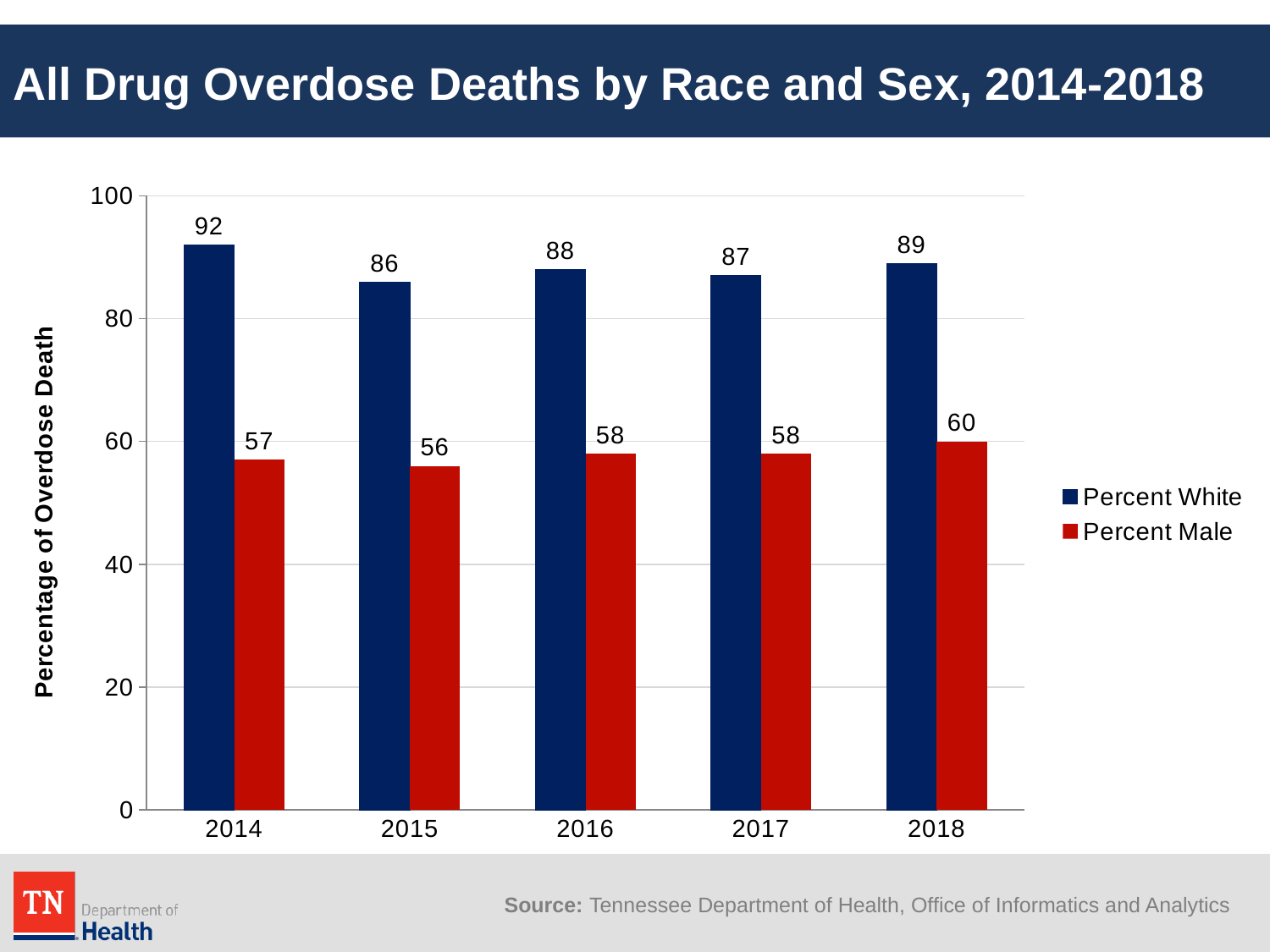
How many series does the legend list? 2 What kind of chart is shown on the slide? bar chart Is the Percent Male value for 2017 greater or less than 40? greater Which year has the lowest Percent Male value? 2015 What is the Percent Male value for 2015? 56 What is the Percent Male value for 2018? 60 Which is larger, the Percent White value for 2015 or the Percent White value for 2018? 2018 What is the title of the chart? All Drug Overdose Deaths by Race and Sex, 2014-2018 Which year has the highest Percent White value? 2014 What is the difference between the Percent White and Percent Male values in 2016? 30 How many years are shown on the x axis? 5 What is the Percent White value for 2014? 92